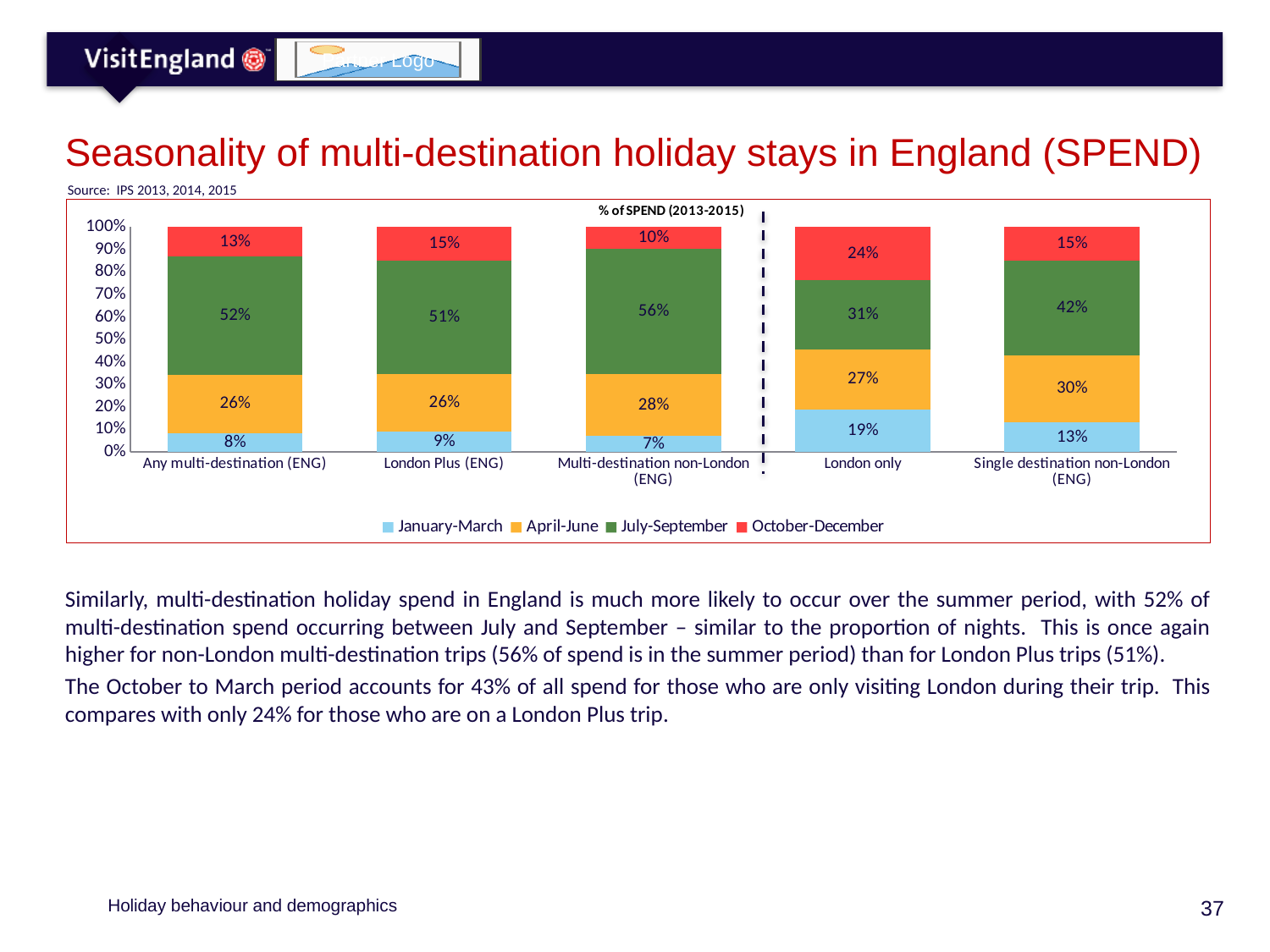
What percentage of spend for London only occurs in October-December? 24% Which colour represents July-September in the chart? Green What is the April-June value for London Plus (ENG)? 26% Which is larger: the October-December share for London only or for London Plus (ENG)? London only Which category has the lowest January-March share of spend? Multi-destination non-London (ENG) What is the difference between the July-September share for Any multi-destination (ENG) and London only? 21% How many categories are shown on the x axis? 5 How many series does the legend list? 4 Which category has the highest July-September share of spend? Multi-destination non-London (ENG) What is the July-September share of spend for Multi-destination non-London (ENG)? 56% What is the January-March value for Single destination non-London (ENG)? 13% What kind of chart is shown on the slide? Stacked bar chart